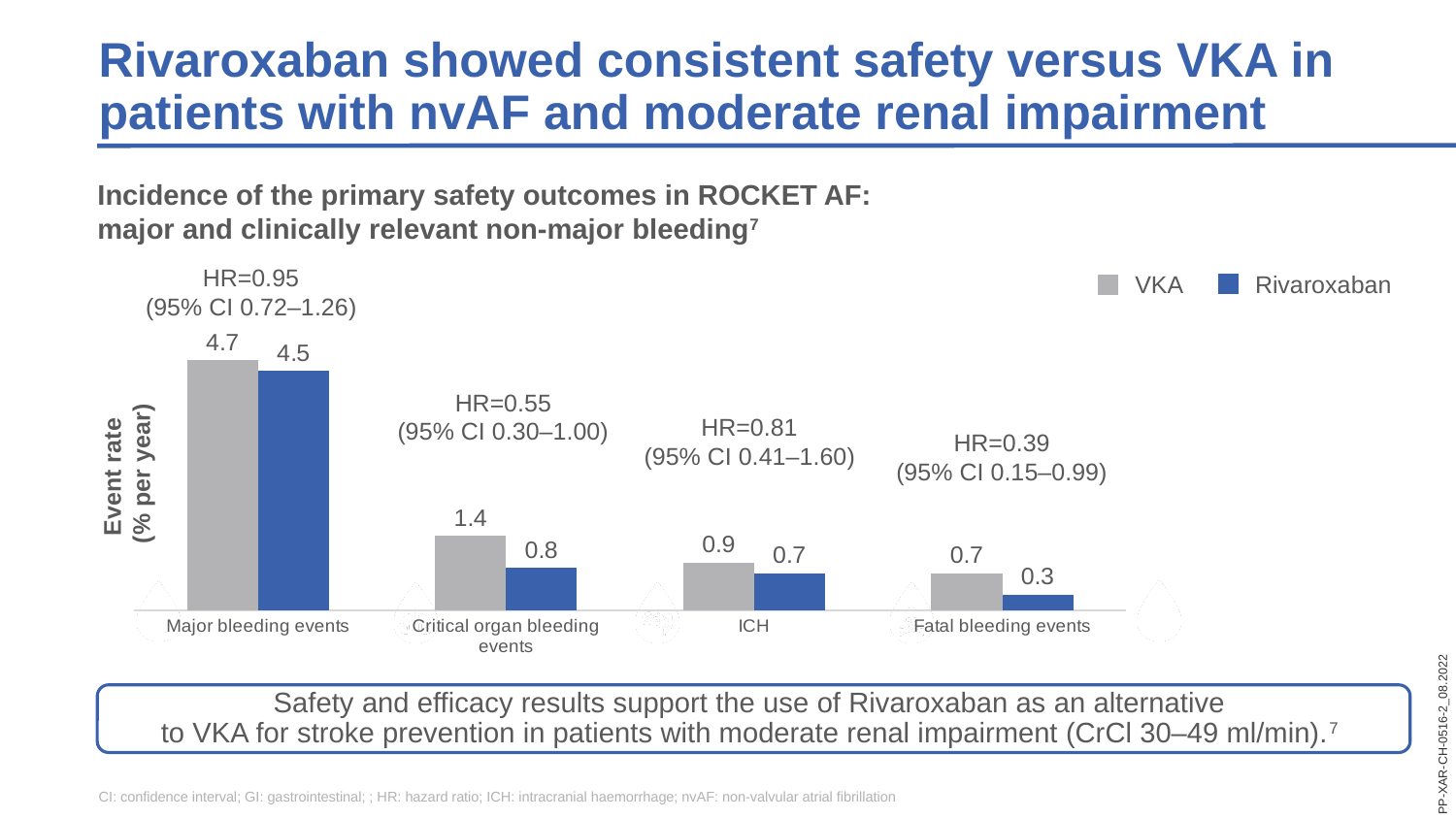
Which is larger in the Fatal bleeding events category, the VKA or the Rivaroxaban event rate? VKA What is the event rate for VKA in the ICH category? 0.9 What is the event rate for VKA in the Major bleeding events category? 4.7 What is the event rate for Rivaroxaban in the Fatal bleeding events category? 0.3 What is the event rate for Rivaroxaban in the Critical organ bleeding events category? 0.8 Which category has the lowest event rate for Rivaroxaban? Fatal bleeding events Which category has the highest event rate for VKA? Major bleeding events What is the difference between the VKA and Rivaroxaban event rates for Critical organ bleeding events? 0.6 How many series does the legend list? 2 How many categories are shown on the x axis of the chart? 4 What kind of chart is shown on the slide? Bar chart What hazard ratio is shown above the Fatal bleeding events bars? HR=0.39